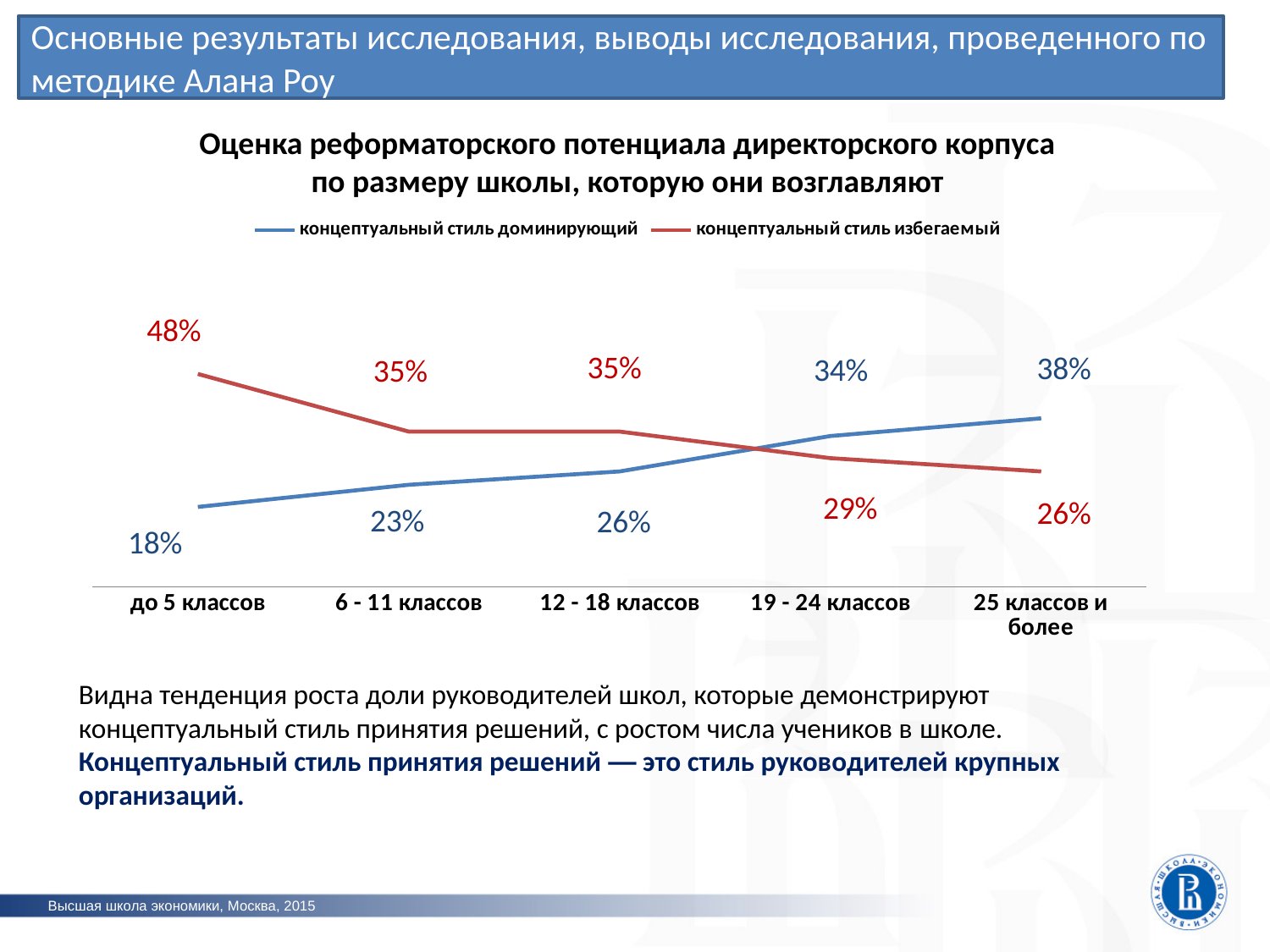
В какой категории значение ряда «концептуальный стиль доминирующий» наибольшее? 25 классов и более Какое значение ряда «концептуальный стиль доминирующий» для категории «до 5 классов»? 18% Какой ряд имеет большее значение в категории «25 классов и более»: «концептуальный стиль доминирующий» или «концептуальный стиль избегаемый»? концептуальный стиль доминирующий Какой тип диаграммы показан на слайде? линейная диаграмма Как изменяются значения ряда «концептуальный стиль избегаемый» при движении по оси x от «до 5 классов» к «25 классов и более»? снижаются В какой категории значение ряда «концептуальный стиль избегаемый» наименьшее? 25 классов и более Какое значение ряда «концептуальный стиль доминирующий» для категории «19 - 24 классов»? 34% Сколько категорий размера школы показано по оси x? 5 Какое значение ряда «концептуальный стиль избегаемый» для категории «25 классов и более»? 26% Сколько рядов данных указано в легенде диаграммы? 2 Какое значение ряда «концептуальный стиль избегаемый» для категории «до 5 классов»? 48% На сколько процентных пунктов значение ряда «концептуальный стиль избегаемый» для «до 5 классов» больше значения ряда «концептуальный стиль доминирующий» для той же категории? 30